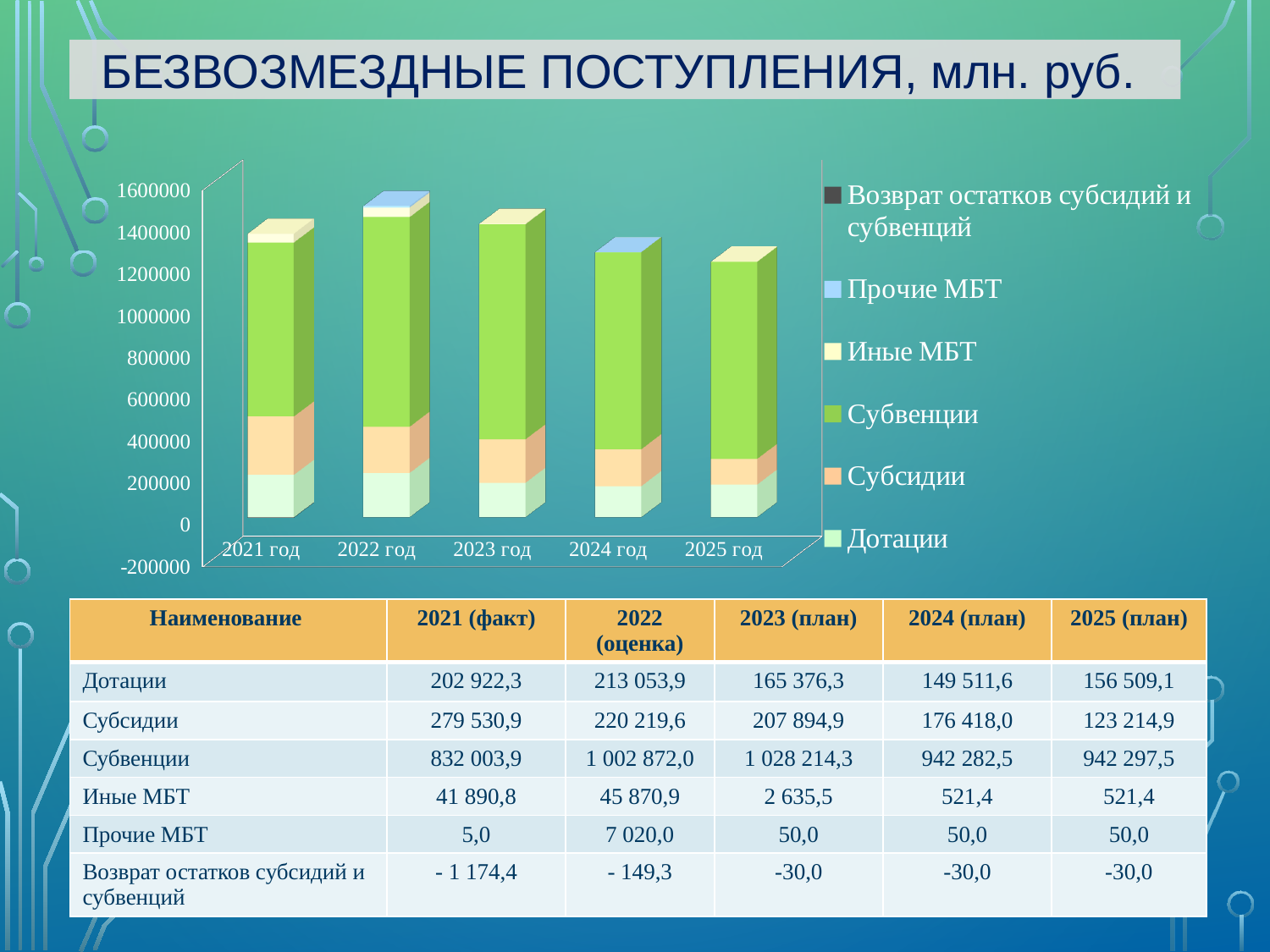
Which is larger in 2021: Дотации or Субсидии? Субсидии In which year is the value of Субсидии the lowest? 2025 What is the value of Дотации for 2021 (факт)? 202 922,3 In which year is the value of Субвенции the highest? 2023 Is the total height of the stacked bar for 2021 год greater or less than 1200000? greater Do the Субсидии values rise or fall from 2021 to 2025? fall What is the value of Субвенции for 2023 (план)? 1 028 214,3 What kind of chart is shown on the slide? Stacked bar chart What is the title of the chart slide? БЕЗВОЗМЕЗДНЫЕ ПОСТУПЛЕНИЯ, млн. руб. How many series does the chart legend list? 6 What is the difference between the Субсидии value for 2021 and for 2025? 156 316,0 How many years (categories) are plotted along the x axis of the chart? 5